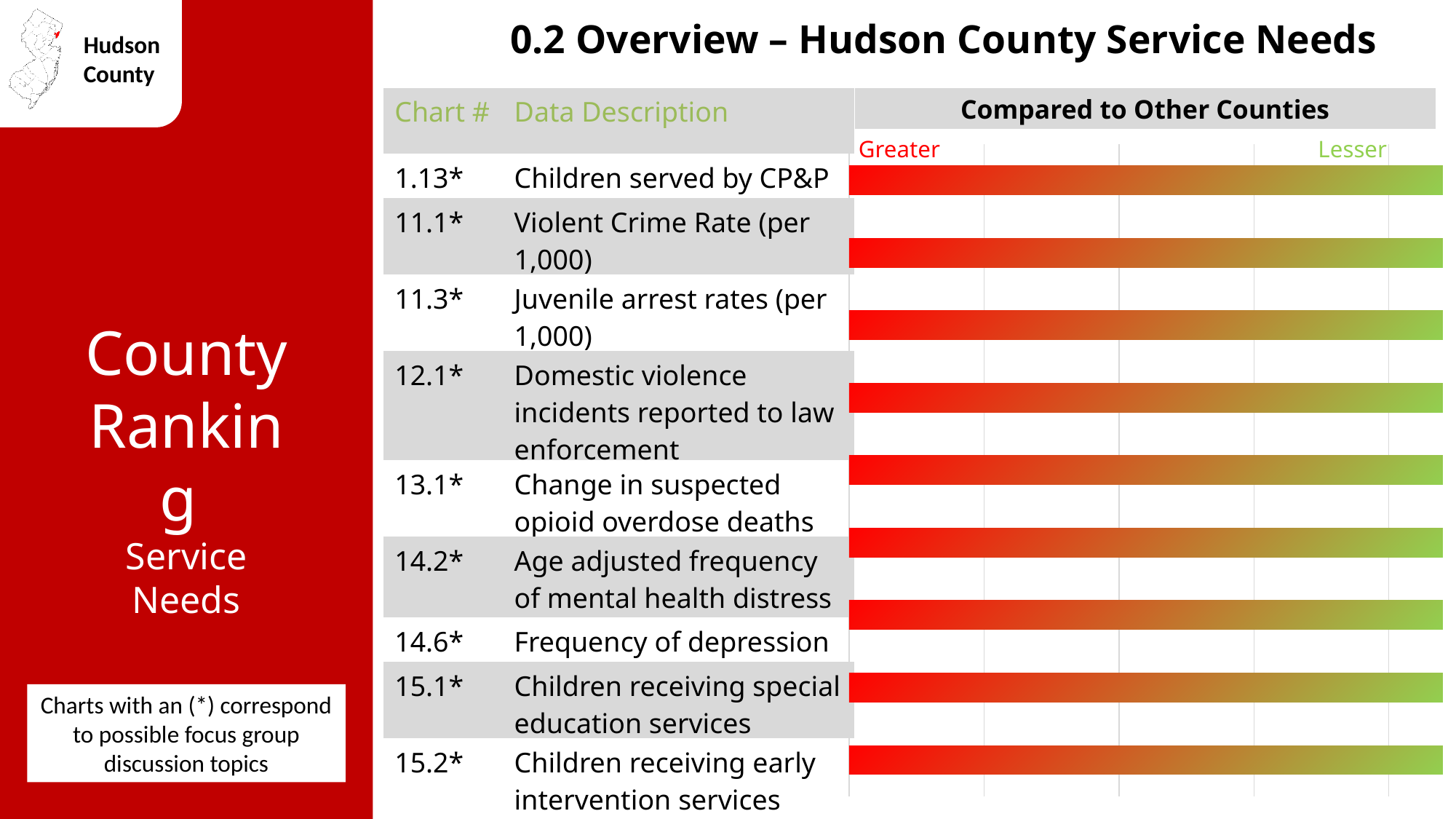
What data description is listed for chart 15.2*? Children receiving early intervention services What kind of chart is shown under "Compared to Other Counties"? bar chart What label appears at the left end of the bar scale, and what label appears at the right end? Greater (left), Lesser (right) What is the heading above the bars on the right side of the slide? Compared to Other Counties What data description is listed for chart 13.1*? Change in suspected opioid overdose deaths Which chart number corresponds to "Children served by CP&P"? 1.13* Which chart number corresponds to "Frequency of depression"? 14.6* How many data description rows (bars) are shown in the "Compared to Other Counties" chart? 9